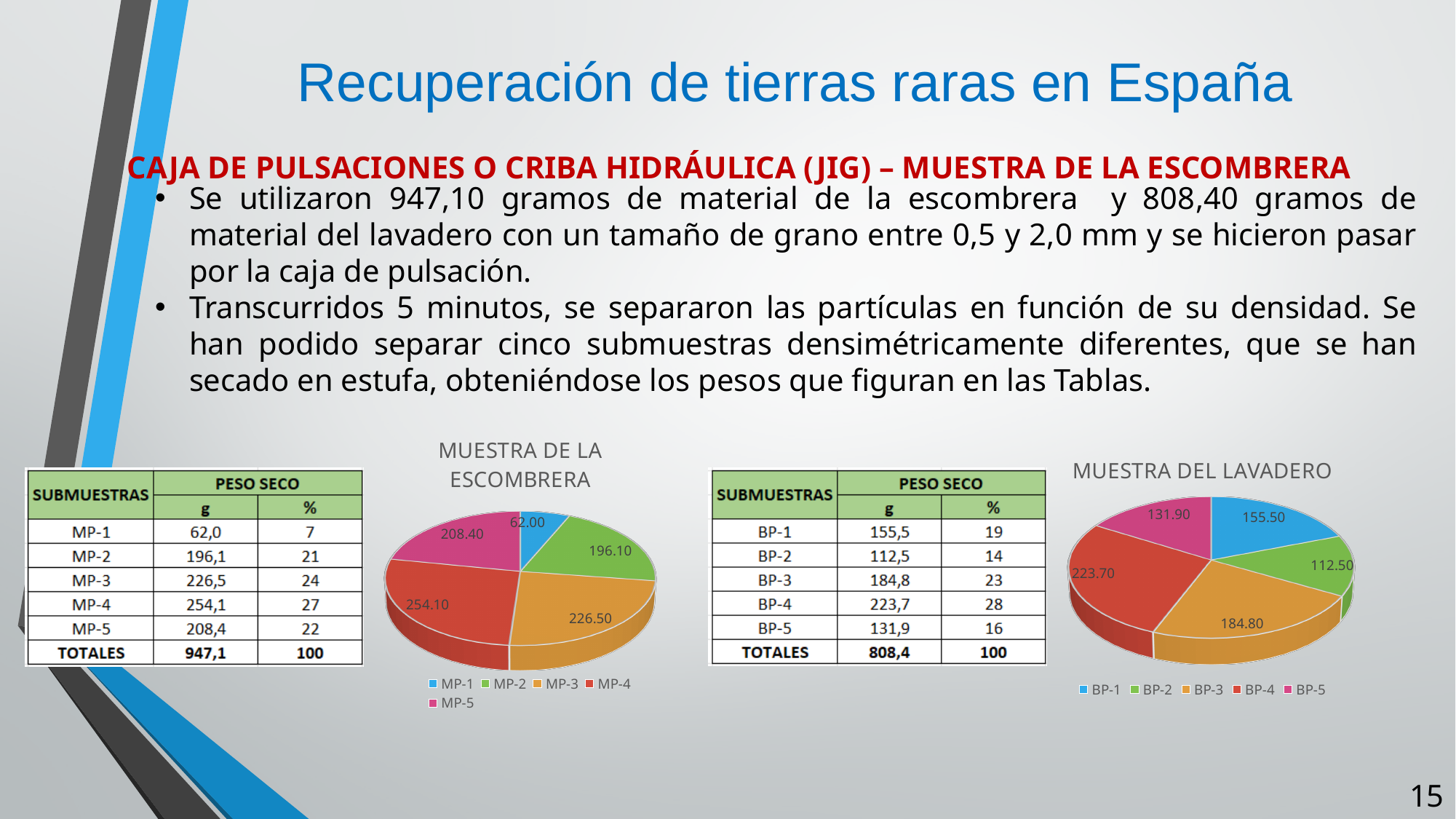
In the MUESTRA DE LA ESCOMBRERA chart, what is the value for MP-3? 226.50 What kind of chart is the MUESTRA DE LA ESCOMBRERA chart? Pie chart In the MUESTRA DE LA ESCOMBRERA chart, what is the difference between the values for MP-4 and MP-1? 192.10 In the MUESTRA DEL LAVADERO chart, what is the value for BP-2? 112.50 In the MUESTRA DE LA ESCOMBRERA chart, how many slices does the pie have? 5 In the MUESTRA DEL LAVADERO chart, how many entries does the legend list? 5 In the MUESTRA DEL LAVADERO chart, which is larger, BP-1 or BP-3? BP-3 In the MUESTRA DEL LAVADERO chart, what is the value for BP-4? 223.70 In the MUESTRA DE LA ESCOMBRERA chart, which submuestra has the smallest slice? MP-1 In the MUESTRA DE LA ESCOMBRERA chart, which submuestra has the largest slice? MP-4 In the MUESTRA DEL LAVADERO chart, what is the difference between the values for BP-4 and BP-2? 111.20 In the MUESTRA DEL LAVADERO chart, which submuestra has the smallest slice? BP-2